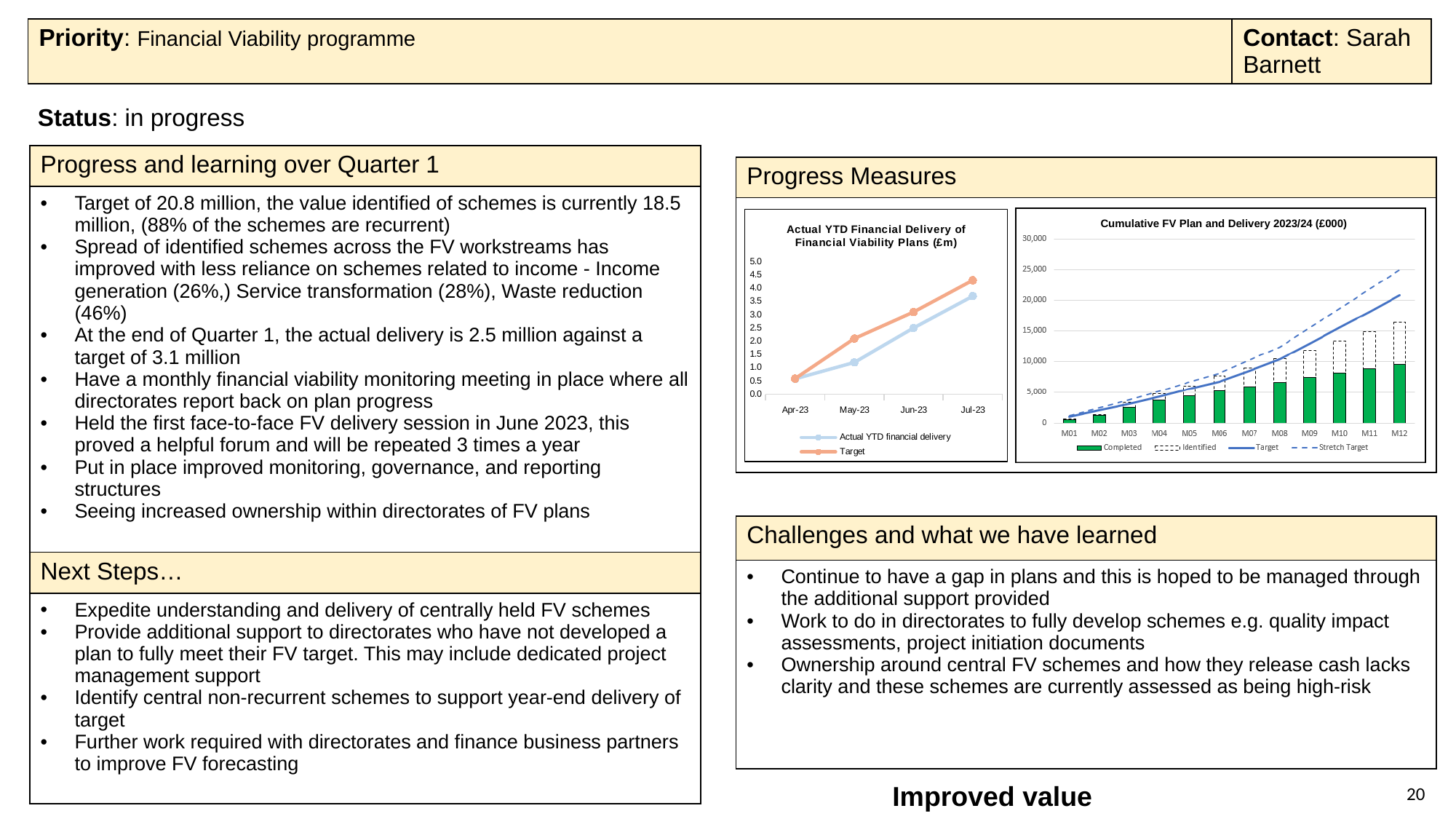
What kind of chart is the 'Actual YTD Financial Delivery of Financial Viability Plans (£m)' chart? line chart How many months are shown on the x axis of the 'Cumulative FV Plan and Delivery 2023/24 (£000)' chart? 12 In the 'Actual YTD Financial Delivery of Financial Viability Plans (£m)' chart, does the Actual YTD financial delivery rise or fall from Apr-23 to Jul-23? rise In the 'Cumulative FV Plan and Delivery 2023/24 (£000)' chart, which line is higher at M12, Target or Stretch Target? Stretch Target In the 'Actual YTD Financial Delivery of Financial Viability Plans (£m)' chart, is the Actual YTD financial delivery value for May-23 greater or less than 1.5? less How many series does the legend of the 'Actual YTD Financial Delivery of Financial Viability Plans (£m)' chart list? 2 In the 'Actual YTD Financial Delivery of Financial Viability Plans (£m)' chart, which series is higher at Jul-23, Actual YTD financial delivery or Target? Target How many series does the legend of the 'Cumulative FV Plan and Delivery 2023/24 (£000)' chart list? 4 In the 'Actual YTD Financial Delivery of Financial Viability Plans (£m)' chart, is the Actual YTD financial delivery value for Jul-23 greater or less than 3.0? greater How many months are shown on the x axis of the 'Actual YTD Financial Delivery of Financial Viability Plans (£m)' chart? 4 In the 'Cumulative FV Plan and Delivery 2023/24 (£000)' chart, is the Target value at M12 greater or less than 20,000? greater